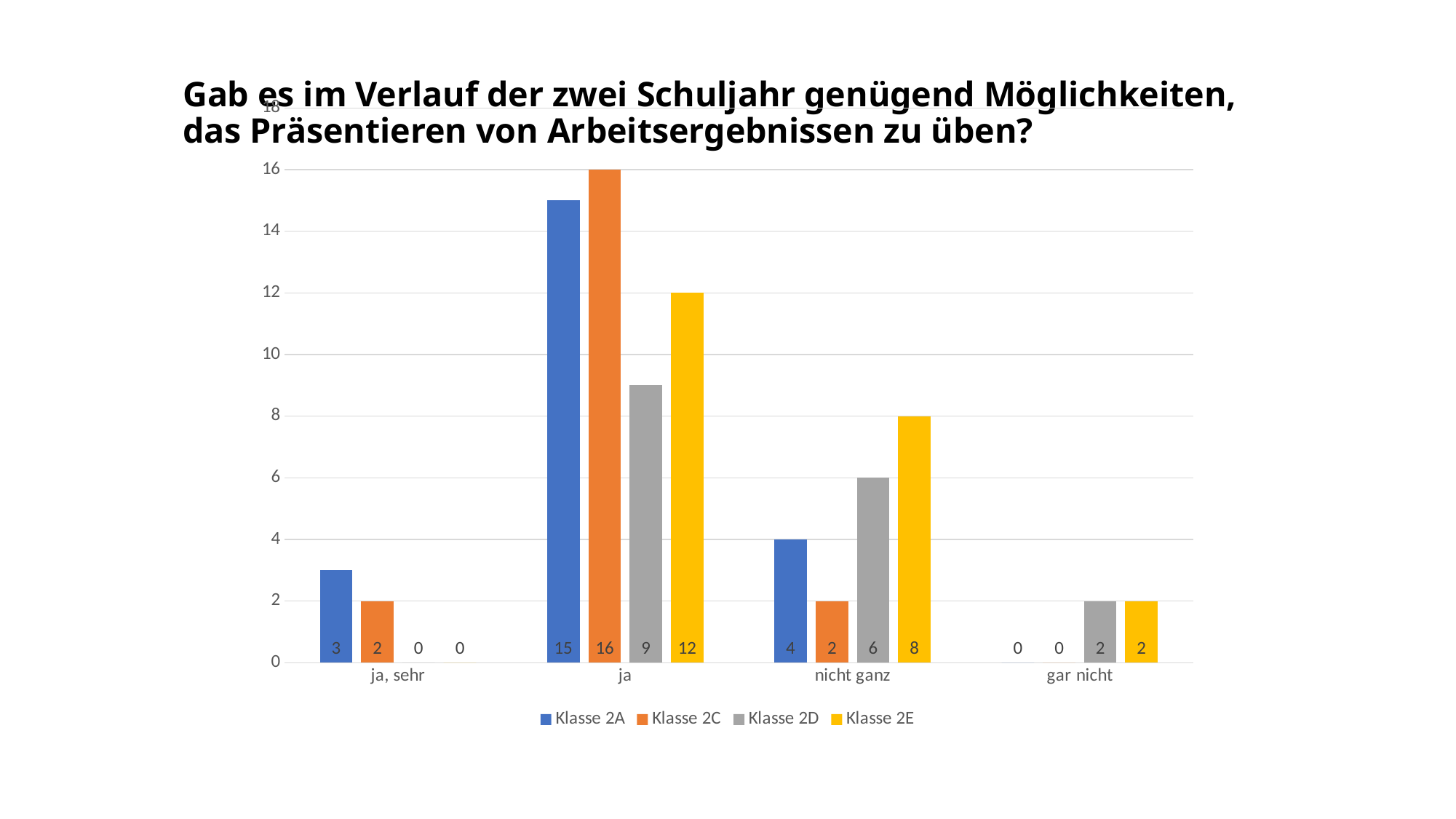
Is the value for Klasse 2A in the "ja" category greater or less than 10? greater How many categories are shown on the x axis? 4 What is the value for Klasse 2C in the "ja" category? 16 Which series has the lowest value in the "ja" category? Klasse 2D Which is larger in the "nicht ganz" category: Klasse 2A or Klasse 2D? Klasse 2D What kind of chart is shown on the slide? bar chart Which colour represents Klasse 2E in the chart? yellow Which category has the highest value for Klasse 2A? ja What is the difference between Klasse 2E and Klasse 2D in the "ja" category? 3 How many series does the legend list? 4 What is the value for Klasse 2E in the "nicht ganz" category? 8 What is the value for Klasse 2D in the "gar nicht" category? 2